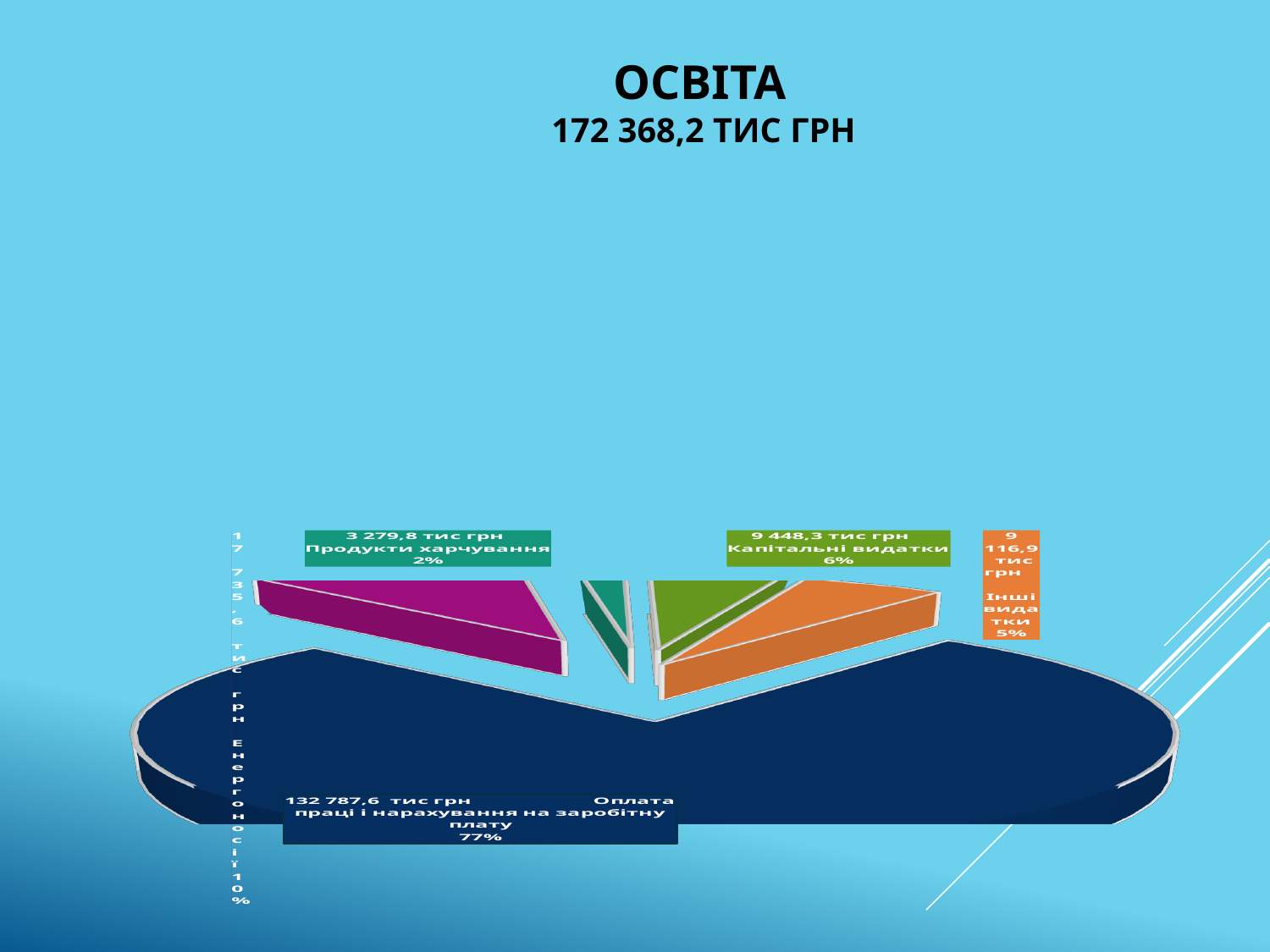
What is the value for Капітальні видатки? 9 448,3 тис грн What is the value for Енергоносії? 17 735.6 тис грн What kind of chart is shown on the slide? pie chart Which category has the smallest slice? Продукти харчування What total amount is shown under the chart title ОСВІТА? 172 368,2 ТИС ГРН Which category has the largest slice? Оплата праці і нарахування на заробітну плату What share of the pie does Інші видатки represent? 5% What share of the pie does Оплата праці і нарахування на заробітну плату represent? 77% What is the value for Оплата праці і нарахування на заробітну плату? 132 787,6 тис грн What share of the pie does Продукти харчування represent? 2% How many slices does the pie chart have? 5 Which is larger, Капітальні видатки or Інші видатки? Капітальні видатки